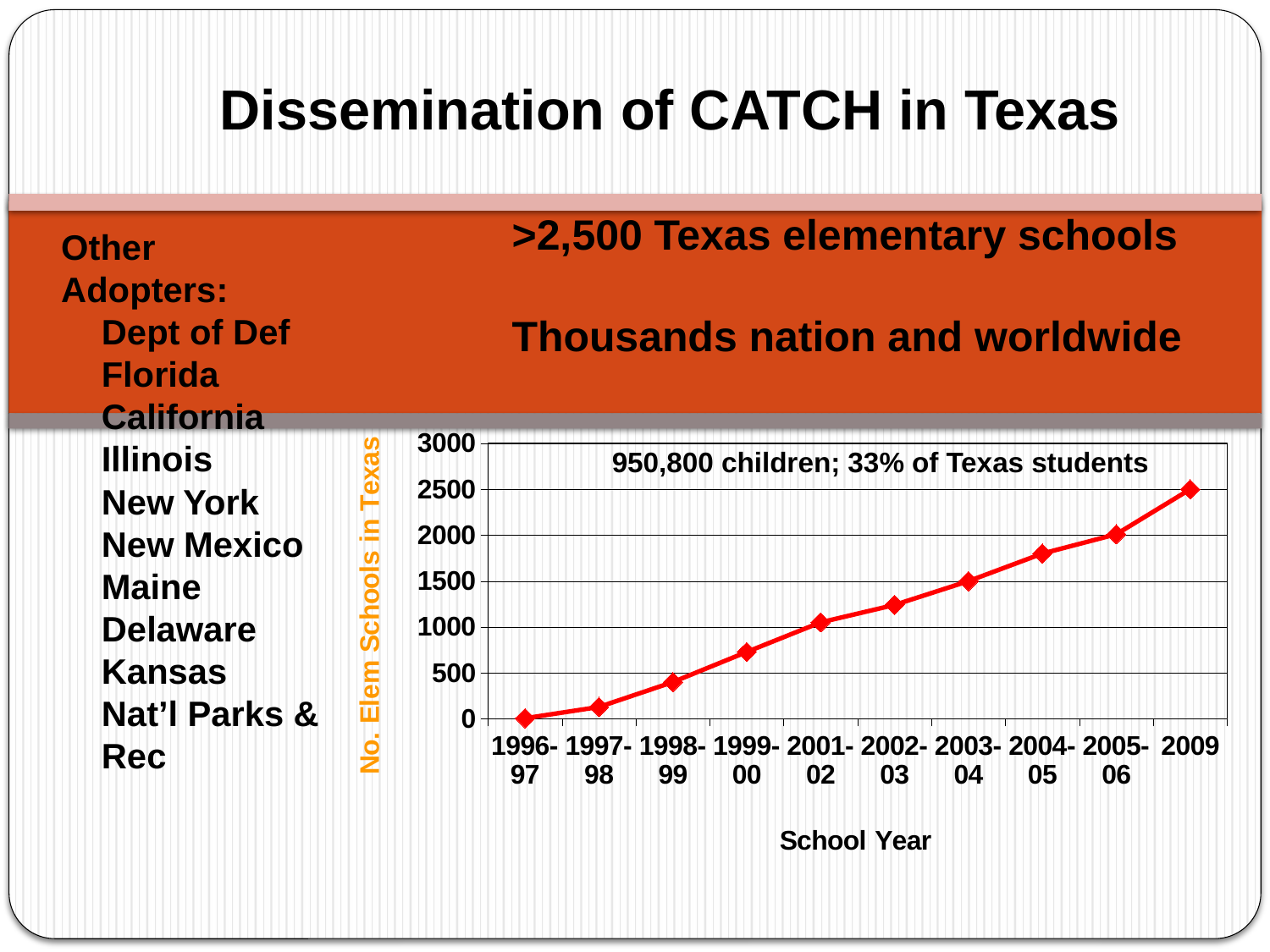
Which school year has the lowest number of elementary schools in the chart? 1996-97 Which school year has a larger value, 2002-03 or 2004-05? 2004-05 Is the value for 1998-99 greater or less than 500? less Which school year has the highest number of elementary schools in the chart? 2009 What is the title of the y axis of the chart? No. Elem Schools in Texas What is the number of elementary schools in Texas for 2009? 2500 How many school years are plotted on the x axis of the chart? 10 Is the value for 1999-00 greater or less than 500? greater Is the value for 2004-05 greater or less than 2000? less Do the values in the chart rise or fall from 1996-97 to 2009? rise What kind of chart is shown on the slide? line chart